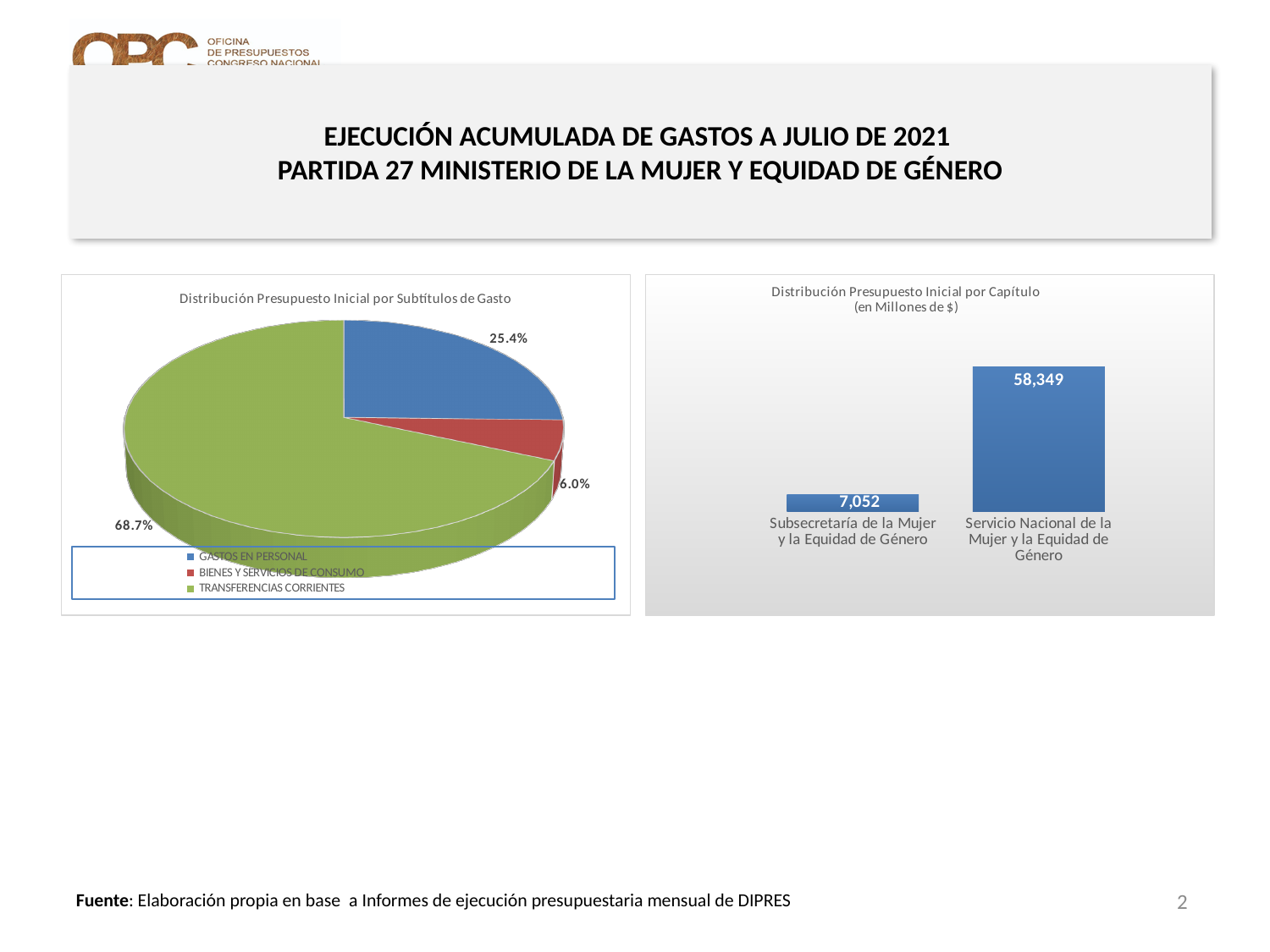
In the chart 'Distribución Presupuesto Inicial por Capítulo', what is the difference between the values for Servicio Nacional de la Mujer y la Equidad de Género and Subsecretaría de la Mujer y la Equidad de Género? 51,297 In the chart 'Distribución Presupuesto Inicial por Subtítulos de Gasto', which category has the smallest slice? BIENES Y SERVICIOS DE CONSUMO What kind of chart is 'Distribución Presupuesto Inicial por Capítulo'? Bar chart In the chart 'Distribución Presupuesto Inicial por Subtítulos de Gasto', what share does BIENES Y SERVICIOS DE CONSUMO have? 6.0% In the chart 'Distribución Presupuesto Inicial por Capítulo', what unit is stated in the title? Millones de $ How many categories does the legend of 'Distribución Presupuesto Inicial por Subtítulos de Gasto' list? 3 In the chart 'Distribución Presupuesto Inicial por Subtítulos de Gasto', what share does GASTOS EN PERSONAL have? 25.4% In the chart 'Distribución Presupuesto Inicial por Subtítulos de Gasto', which category has the largest slice? TRANSFERENCIAS CORRIENTES In the chart 'Distribución Presupuesto Inicial por Subtítulos de Gasto', what share does TRANSFERENCIAS CORRIENTES have? 68.7% What kind of chart is 'Distribución Presupuesto Inicial por Subtítulos de Gasto'? Pie chart In the chart 'Distribución Presupuesto Inicial por Capítulo', what is the value for Servicio Nacional de la Mujer y la Equidad de Género? 58,349 In the chart 'Distribución Presupuesto Inicial por Capítulo', what is the value for Subsecretaría de la Mujer y la Equidad de Género? 7,052